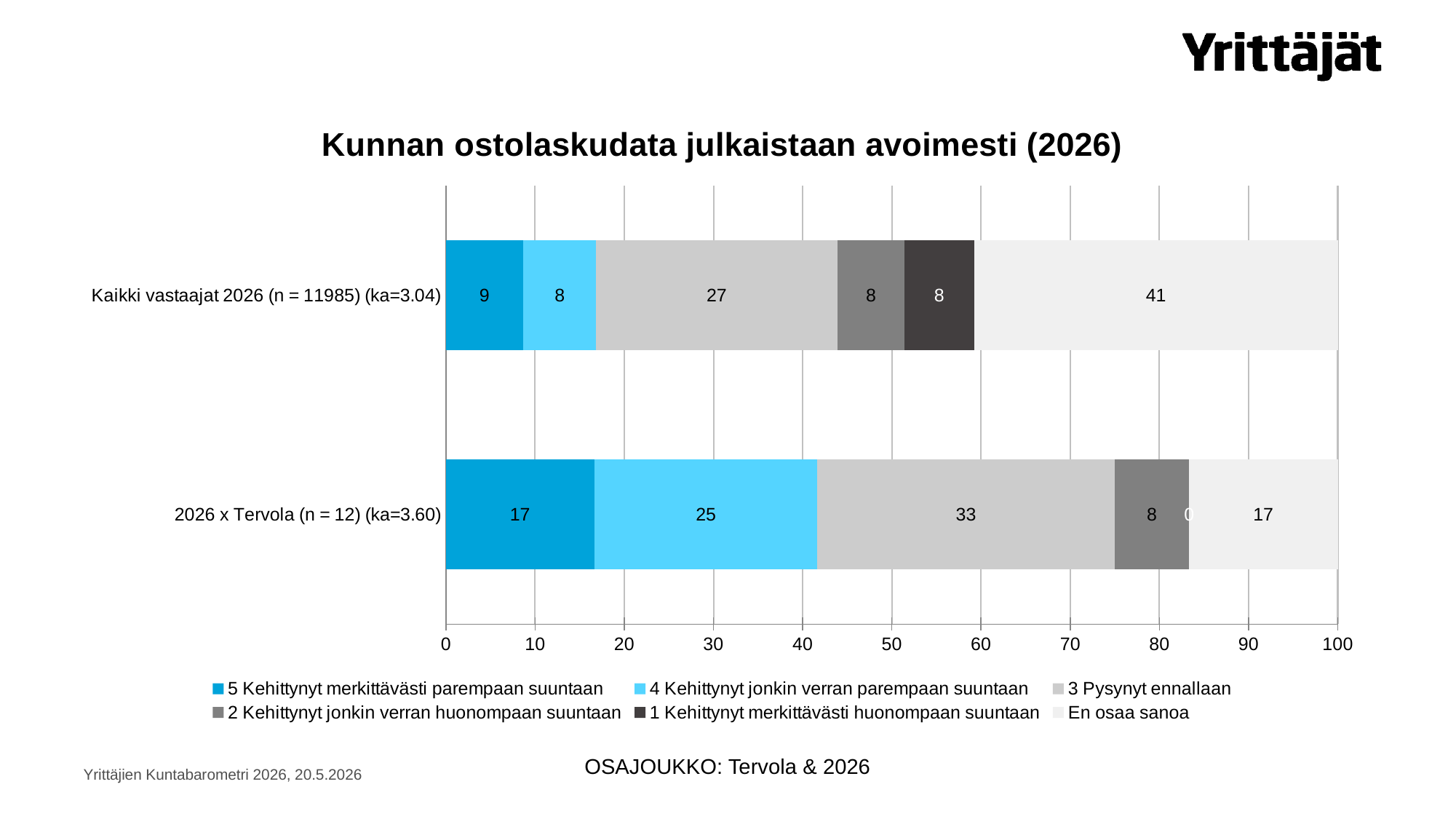
Which has a larger value for "5 Kehittynyt merkittävästi parempaan suuntaan": "Kaikki vastaajat 2026 (n = 11985) (ka=3.04)" or "2026 x Tervola (n = 12) (ka=3.60)"? 2026 x Tervola (n = 12) (ka=3.60) How many series does the legend list? 6 What is the value of "5 Kehittynyt merkittävästi parempaan suuntaan" for "Kaikki vastaajat 2026 (n = 11985) (ka=3.04)"? 9 What is the value of "1 Kehittynyt merkittävästi huonompaan suuntaan" for "2026 x Tervola (n = 12) (ka=3.60)"? 0 What type of chart is shown on the slide? Stacked bar chart What is the value of "3 Pysynyt ennallaan" for "2026 x Tervola (n = 12) (ka=3.60)"? 33 Which segment is the largest in the "Kaikki vastaajat 2026 (n = 11985) (ka=3.04)" bar? En osaa sanoa How many categories (bars) are shown in the chart? 2 What is the value of "En osaa sanoa" for "Kaikki vastaajat 2026 (n = 11985) (ka=3.04)"? 41 What is the value of "4 Kehittynyt jonkin verran parempaan suuntaan" for "2026 x Tervola (n = 12) (ka=3.60)"? 25 What is the difference between the "En osaa sanoa" values for "Kaikki vastaajat 2026 (n = 11985) (ka=3.04)" and "2026 x Tervola (n = 12) (ka=3.60)"? 24 Which segment is the largest in the "2026 x Tervola (n = 12) (ka=3.60)" bar? 3 Pysynyt ennallaan